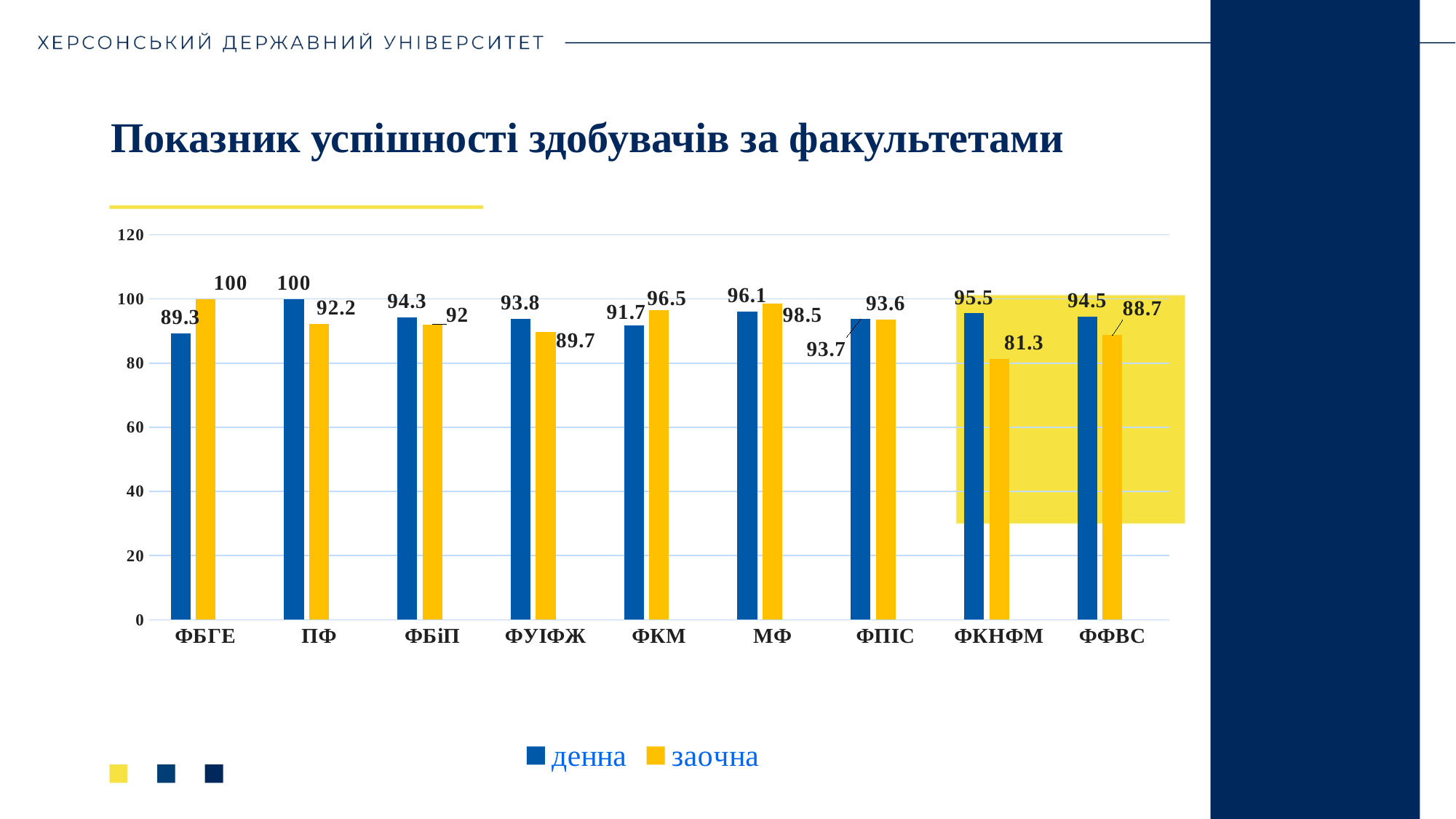
How many series does the legend list? 2 For МФ, which is larger: the денна value or the заочна value? заочна Which faculty has the lowest денна value? ФБГЕ How many faculties are shown on the x axis? 9 Which faculty has the lowest заочна value? ФКНФМ What type of chart is shown on the slide? Bar chart What is the заочна value for ФКМ? 96.5 What is the difference between the заочна and денна values for ФБГЕ? 10.7 What is the денна value for ФКНФМ? 95.5 What is the заочна value for ФКНФМ? 81.3 Which faculty has the highest денна value? ПФ What is the difference between the денна and заочна values for ФКНФМ? 14.2